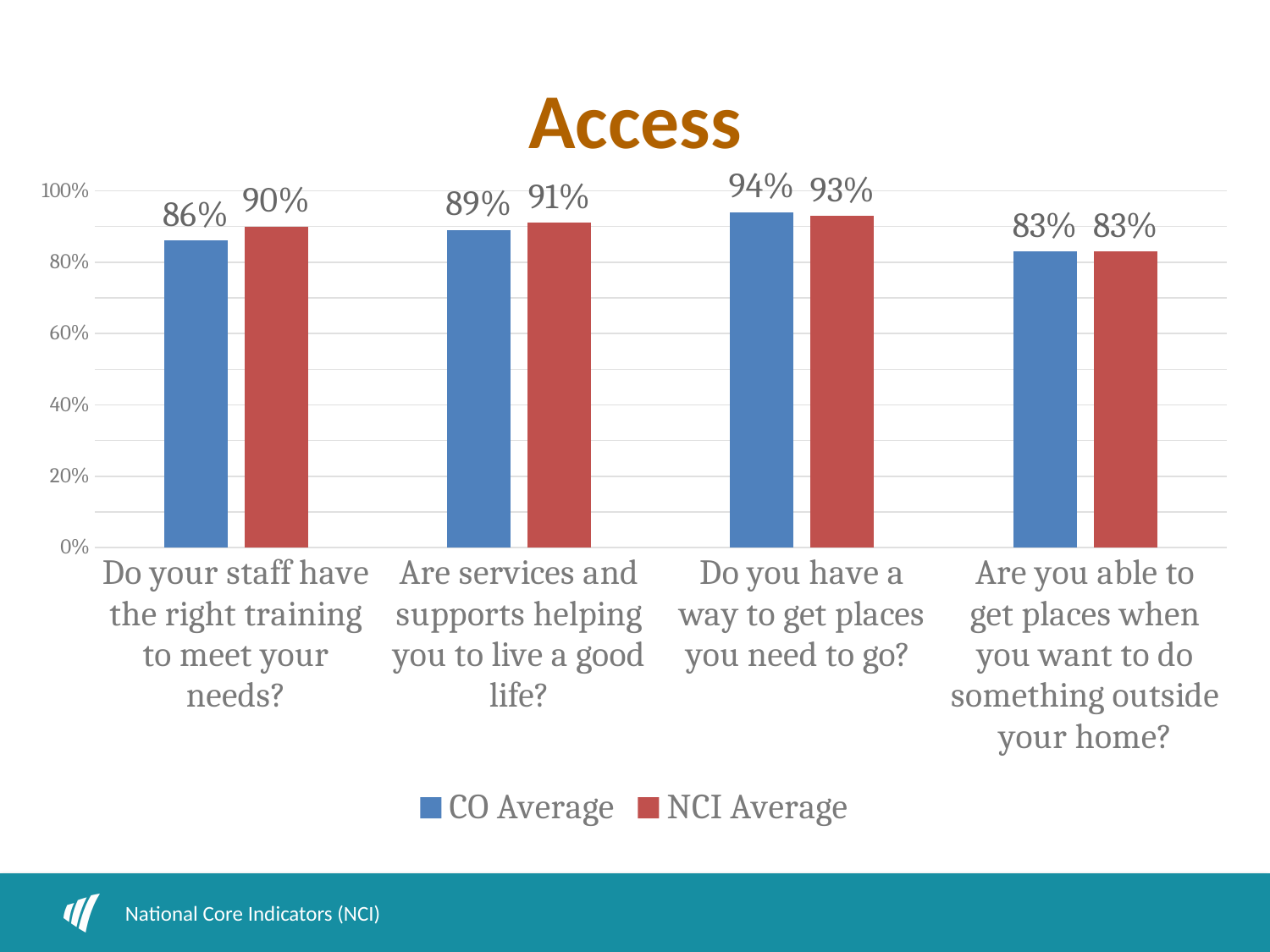
What is the CO Average for "Do you have a way to get places you need to go?"? 94% How many series does the legend list? 2 What kind of chart is shown on the slide? Bar chart Is the CO Average for "Are you able to get places when you want to do something outside your home?" greater or less than 80%? greater What is the CO Average for "Do your staff have the right training to meet your needs?"? 86% What is the NCI Average for "Are services and supports helping you to live a good life?"? 91% What is the difference between the NCI Average and the CO Average for "Do your staff have the right training to meet your needs?"? 4% What is the title of the chart? Access Which question has the highest CO Average? Do you have a way to get places you need to go? Which question has the lowest NCI Average? Are you able to get places when you want to do something outside your home? How many questions (categories) are shown on the x axis? 4 For "Do you have a way to get places you need to go?", which is larger, the CO Average or the NCI Average? CO Average